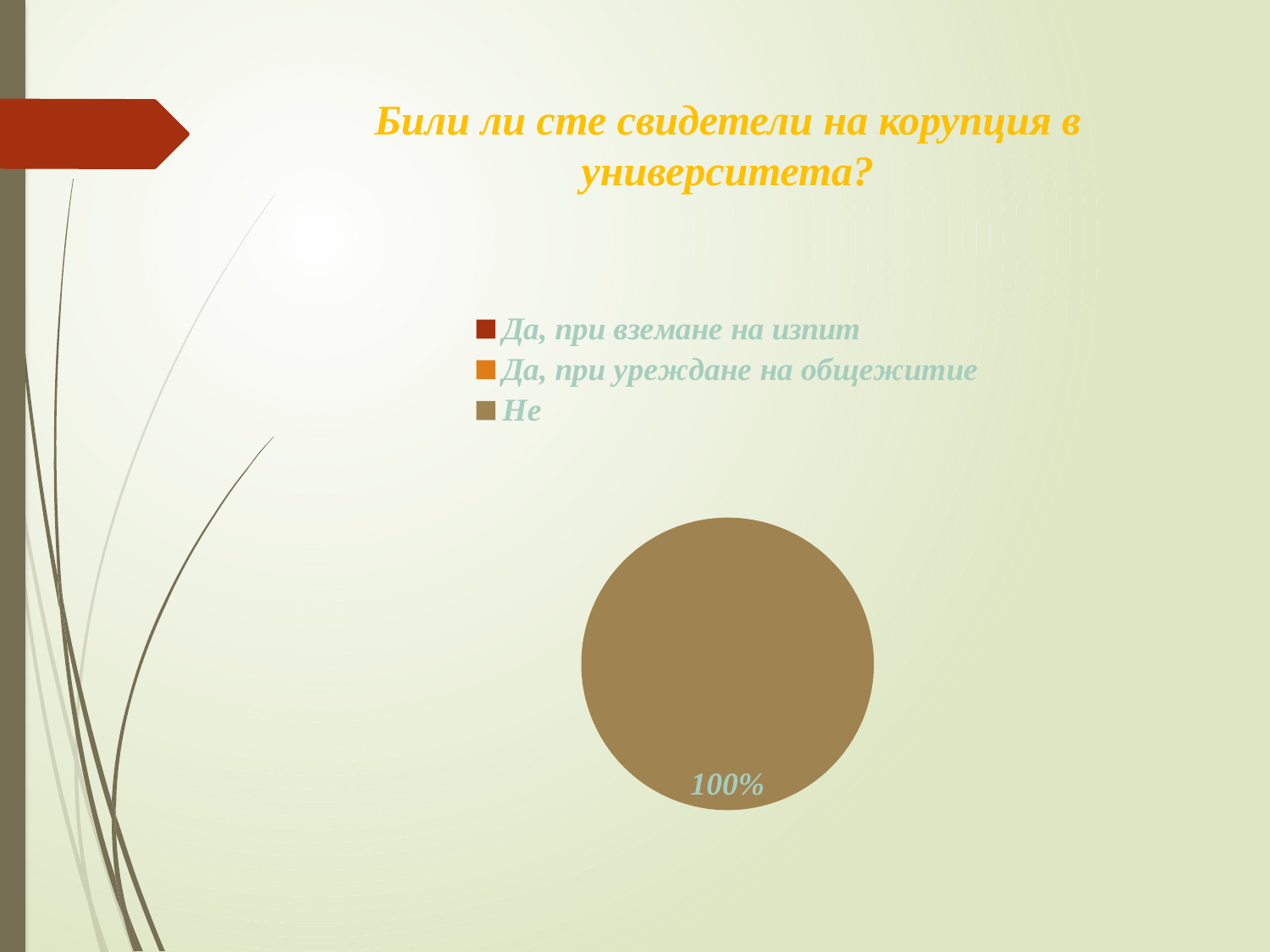
What share of the pie does the "Не" slice take? 100% Which legend entry is shown with an orange marker? Да, при уреждане на общежитие What kind of chart is shown on the slide? pie chart Is the share for "Не" greater or less than 50%? greater How many entries does the legend list? 3 Which is larger, the share for "Не" or the share for "Да, при вземане на изпит"? Не What is the only percentage label printed on the pie? 100% Which category accounts for the whole pie? Не How many slices are visible in the pie? 1 What is the title of the chart? Били ли сте свидетели на корупция в университета?